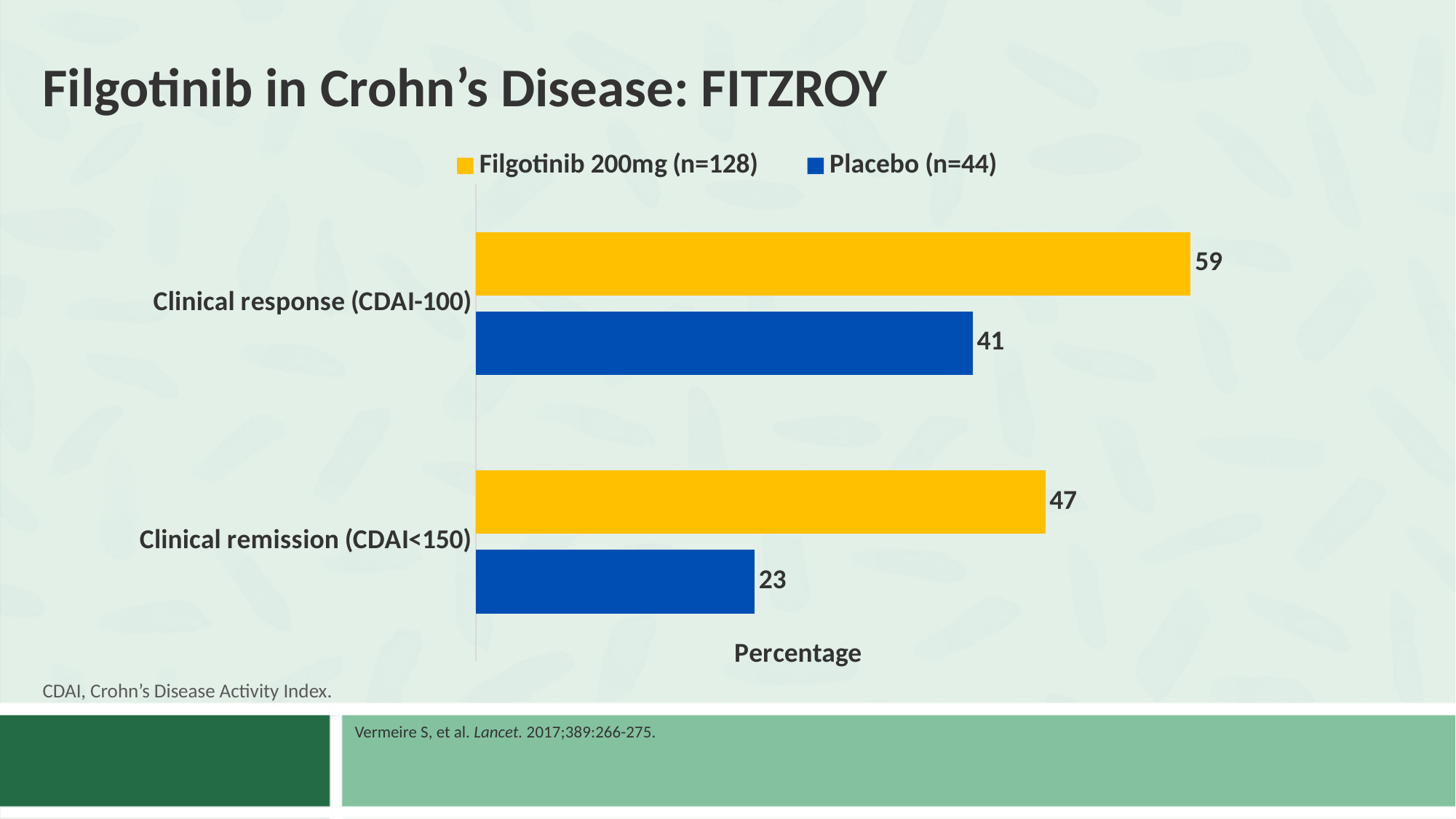
What kind of chart is shown on the slide? Bar chart Which is larger: Placebo (n=44) for Clinical response (CDAI-100) or Filgotinib 200mg (n=128) for Clinical remission (CDAI<150)? Filgotinib 200mg (n=128) for Clinical remission (CDAI<150) What is the value for Filgotinib 200mg (n=128) for Clinical response (CDAI-100)? 59 Which series has the highest value for Clinical response (CDAI-100)? Filgotinib 200mg (n=128) How many series does the legend list? 2 What is the value for Placebo (n=44) for Clinical remission (CDAI<150)? 23 What is the value for Placebo (n=44) for Clinical response (CDAI-100)? 41 Which bar has the lowest value on the chart? Placebo (n=44) for Clinical remission (CDAI<150) How many categories are shown on the chart? 2 What is the difference between Filgotinib 200mg (n=128) and Placebo (n=44) for Clinical remission (CDAI<150)? 24 What is the value for Filgotinib 200mg (n=128) for Clinical remission (CDAI<150)? 47 What is the difference between Filgotinib 200mg (n=128) and Placebo (n=44) for Clinical response (CDAI-100)? 18